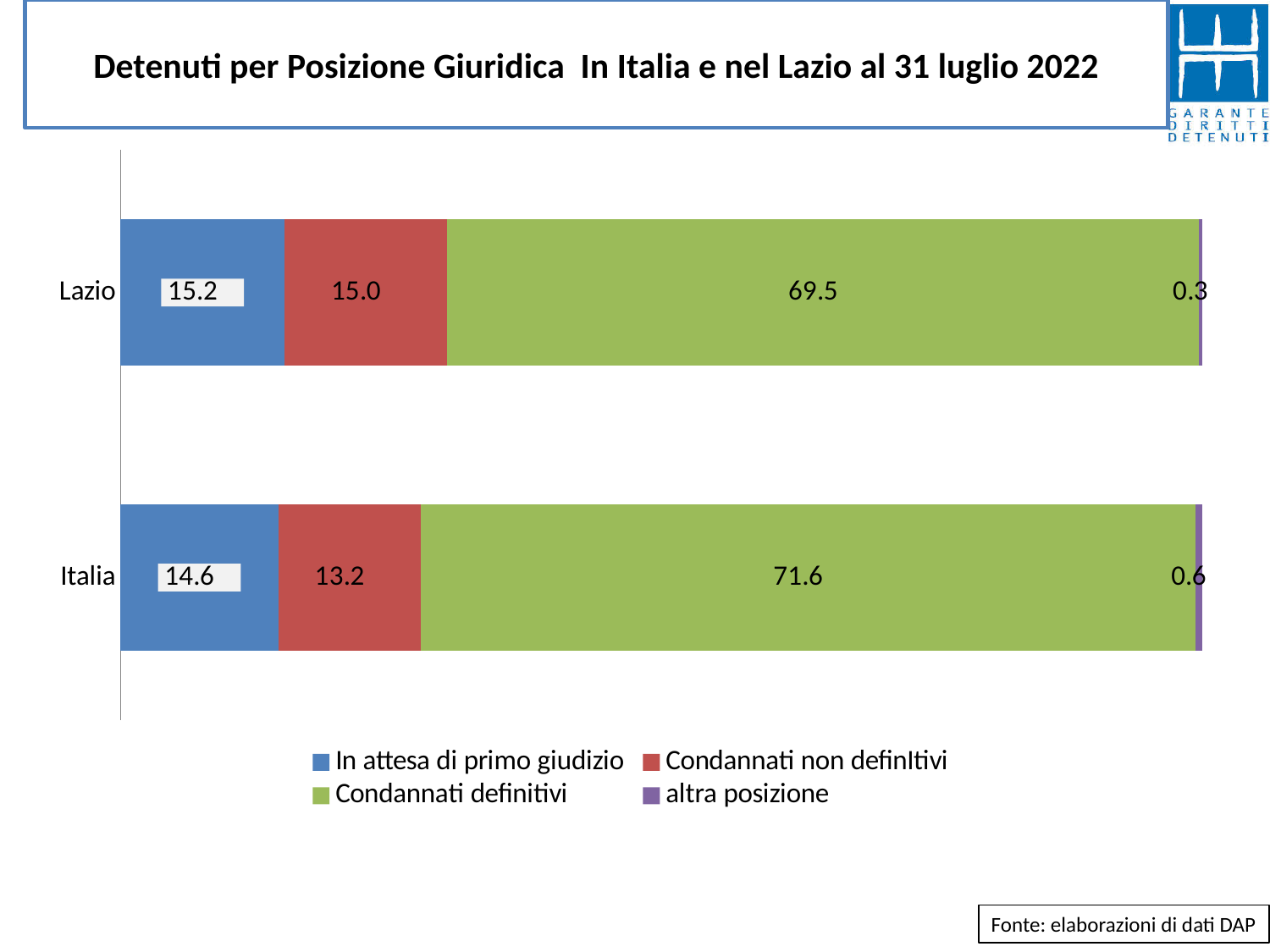
What kind of chart is shown on the slide? Stacked bar chart Which is larger: 'Condannati non definitivi' in Lazio or in Italia? Lazio What is the value for 'In attesa di primo giudizio' in Italia? 14.6 What is the value for 'Condannati definitivi' in Lazio? 69.5 Which series has the smallest value in the Lazio bar? altra posizione How many categories (bars) are shown in the chart? 2 What is the difference between the 'Condannati definitivi' values for Italia and Lazio? 2.1 What is the value for 'Condannati non definitivi' in Lazio? 15.0 Which series has the largest value in the Italia bar? Condannati definitivi How many series does the legend list? 4 What is the value for 'altra posizione' in Italia? 0.6 What is the total of the stacked bar for Lazio? 100.0